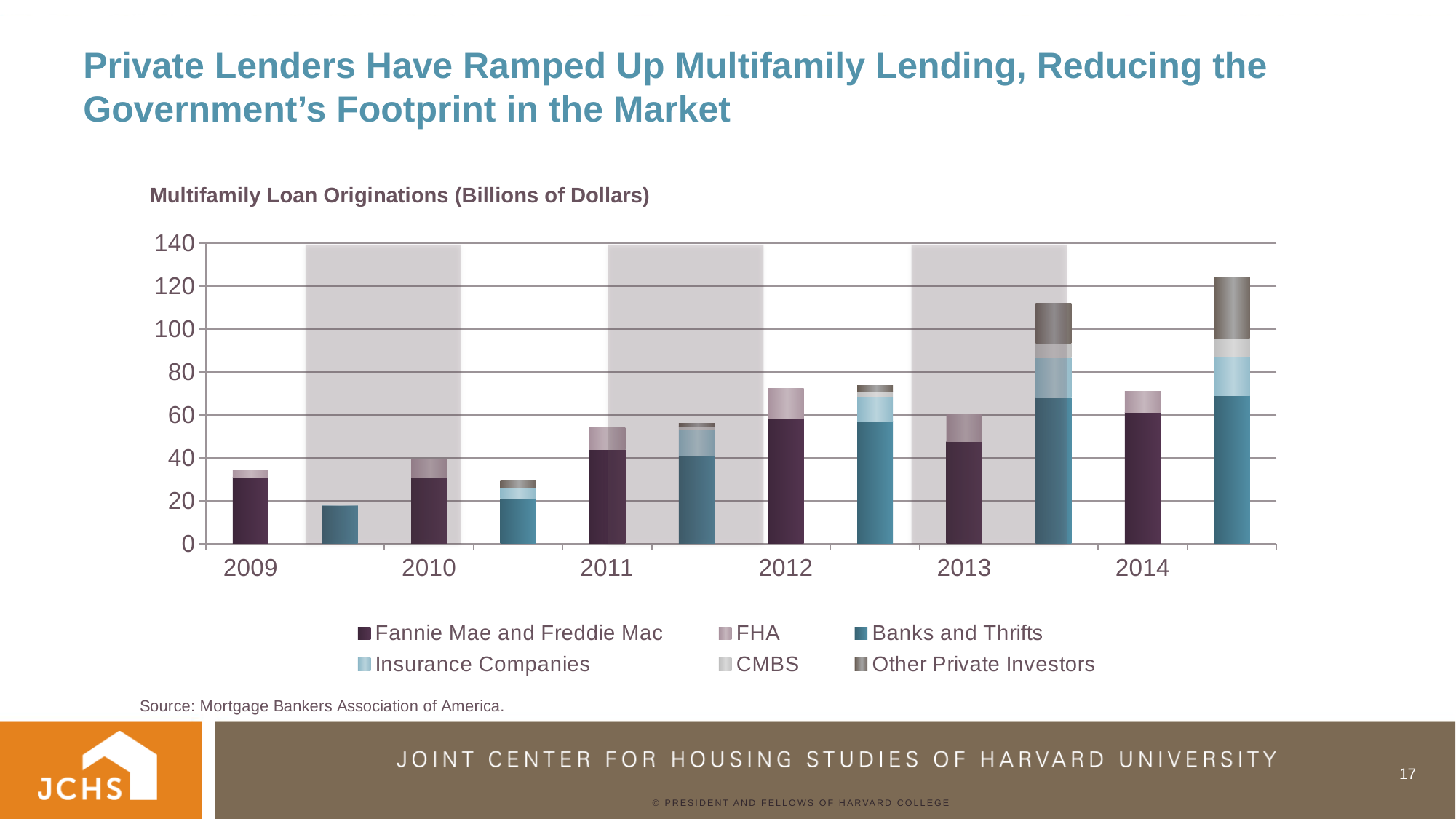
How many series does the legend list? 6 Is the total of the second (right-hand) bar for 2010 greater or less than 40? less Does the Fannie Mae and Freddie Mac segment rise or fall from 2009 to 2012? rise In 2013, which bar is taller: the first bar (Fannie Mae and Freddie Mac plus FHA) or the second bar (private lenders)? the second bar (private lenders) How many years are shown on the x axis? 6 Which year contains the tallest bar in the chart? 2014 Is the total of the first (left-hand) bar for 2009 greater or less than 40? less Is the total of the second (right-hand) bar for 2014 greater or less than 100? greater Which year contains the shortest bar in the chart? 2009 What is the title of the chart? Multifamily Loan Originations (Billions of Dollars) What kind of chart is shown on the slide? stacked bar chart